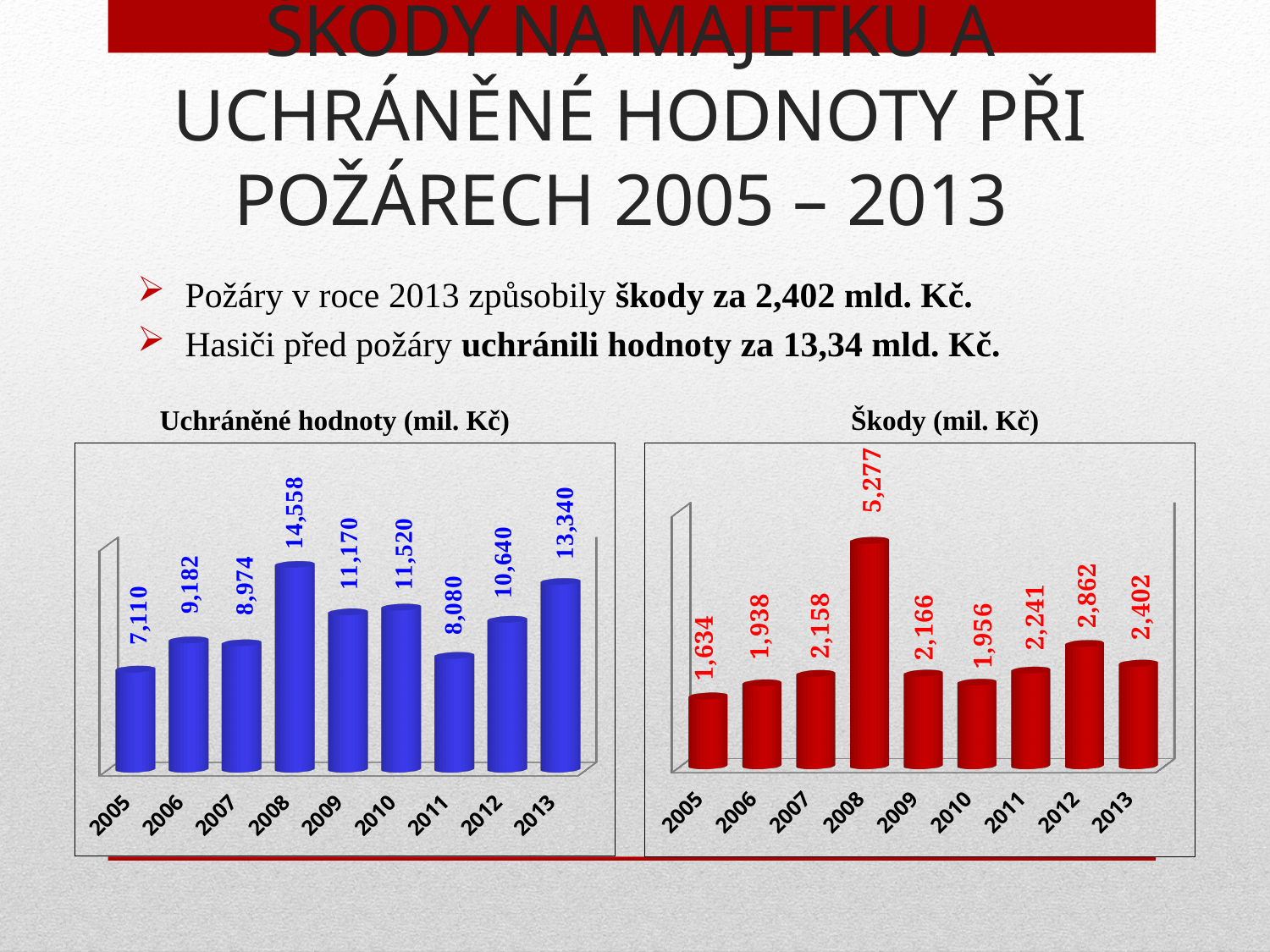
How many years are shown on the x axis of the chart titled "Škody (mil. Kč)"? 9 In the chart titled "Škody (mil. Kč)", which year has the highest value? 2008 In the chart titled "Uchráněné hodnoty (mil. Kč)", which year has the lowest value? 2005 In the chart titled "Škody (mil. Kč)", which is larger, the value for 2006 or the value for 2012? 2012 In the chart titled "Škody (mil. Kč)", which year has the lowest value? 2005 What type of chart is the chart titled "Uchráněné hodnoty (mil. Kč)"? Bar chart What colour are the bars in the chart titled "Škody (mil. Kč)"? Red In the chart titled "Uchráněné hodnoty (mil. Kč)", what is the value for 2008? 14,558 In the chart titled "Uchráněné hodnoty (mil. Kč)", which is larger, the value for 2010 or the value for 2011? 2010 In the chart titled "Škody (mil. Kč)", what is the value for 2013? 2,402 In the chart titled "Uchráněné hodnoty (mil. Kč)", what is the difference between the values for 2008 and 2005? 7,448 In the chart titled "Škody (mil. Kč)", what is the difference between the values for 2012 and 2013? 460